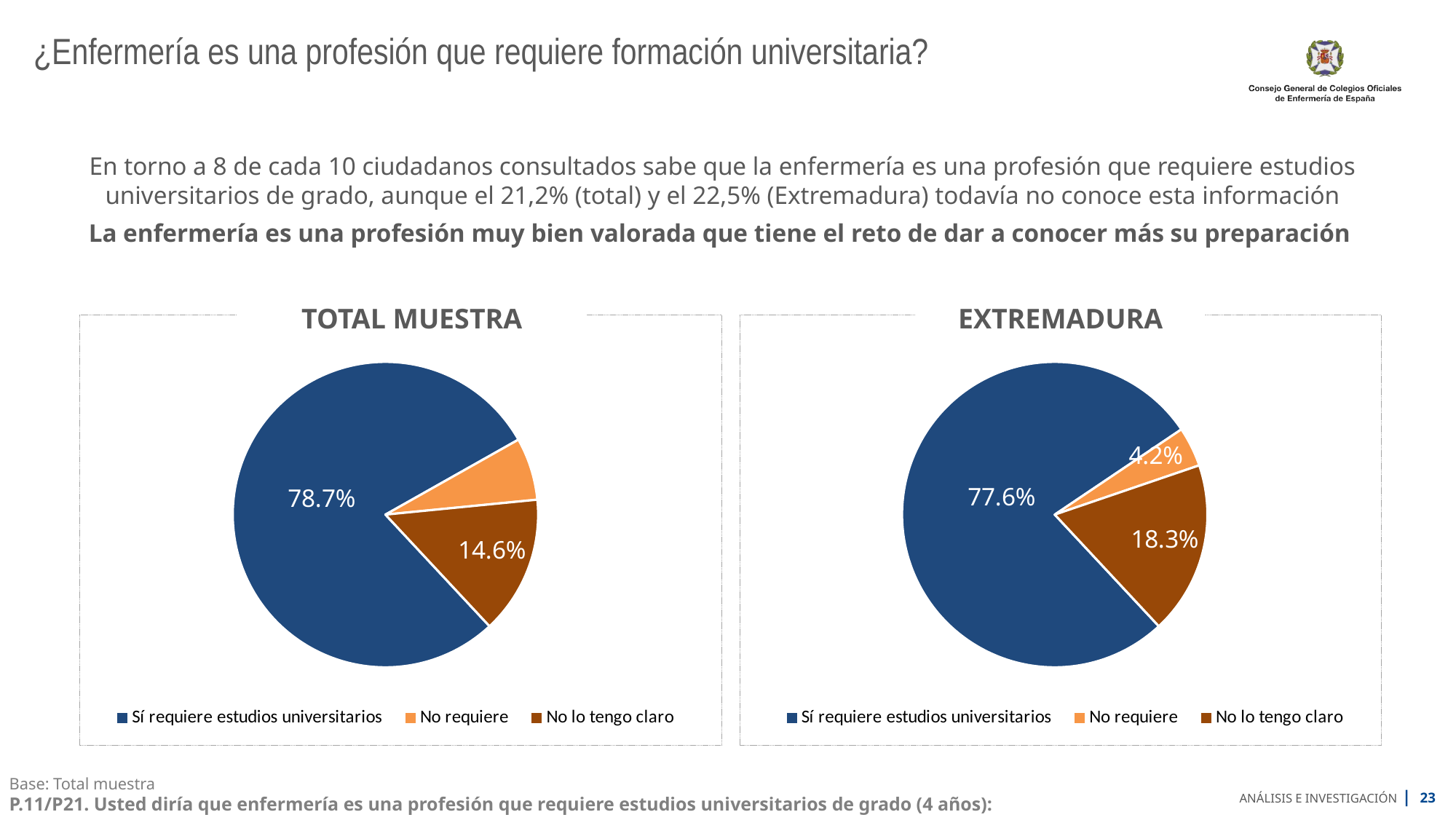
In the EXTREMADURA chart, what percentage corresponds to 'Sí requiere estudios universitarios'? 77.6% In the TOTAL MUESTRA chart, what percentage corresponds to 'Sí requiere estudios universitarios'? 78.7% Which chart shows a higher percentage for 'No lo tengo claro', TOTAL MUESTRA or EXTREMADURA? EXTREMADURA What is the difference in percentage points between 'No lo tengo claro' in the EXTREMADURA chart and in the TOTAL MUESTRA chart? 3.7 How many categories does the legend of the TOTAL MUESTRA chart list? 3 In the EXTREMADURA chart, what percentage corresponds to 'No lo tengo claro'? 18.3% In the TOTAL MUESTRA chart, what percentage corresponds to 'No lo tengo claro'? 14.6% In the EXTREMADURA chart, which category has the smallest slice? No requiere In the TOTAL MUESTRA chart, which category has the largest slice? Sí requiere estudios universitarios In the EXTREMADURA chart, what percentage corresponds to 'No requiere'? 4.2% In the TOTAL MUESTRA chart, what colour is the 'No requiere' slice? Orange What type of chart is used for EXTREMADURA? Pie chart